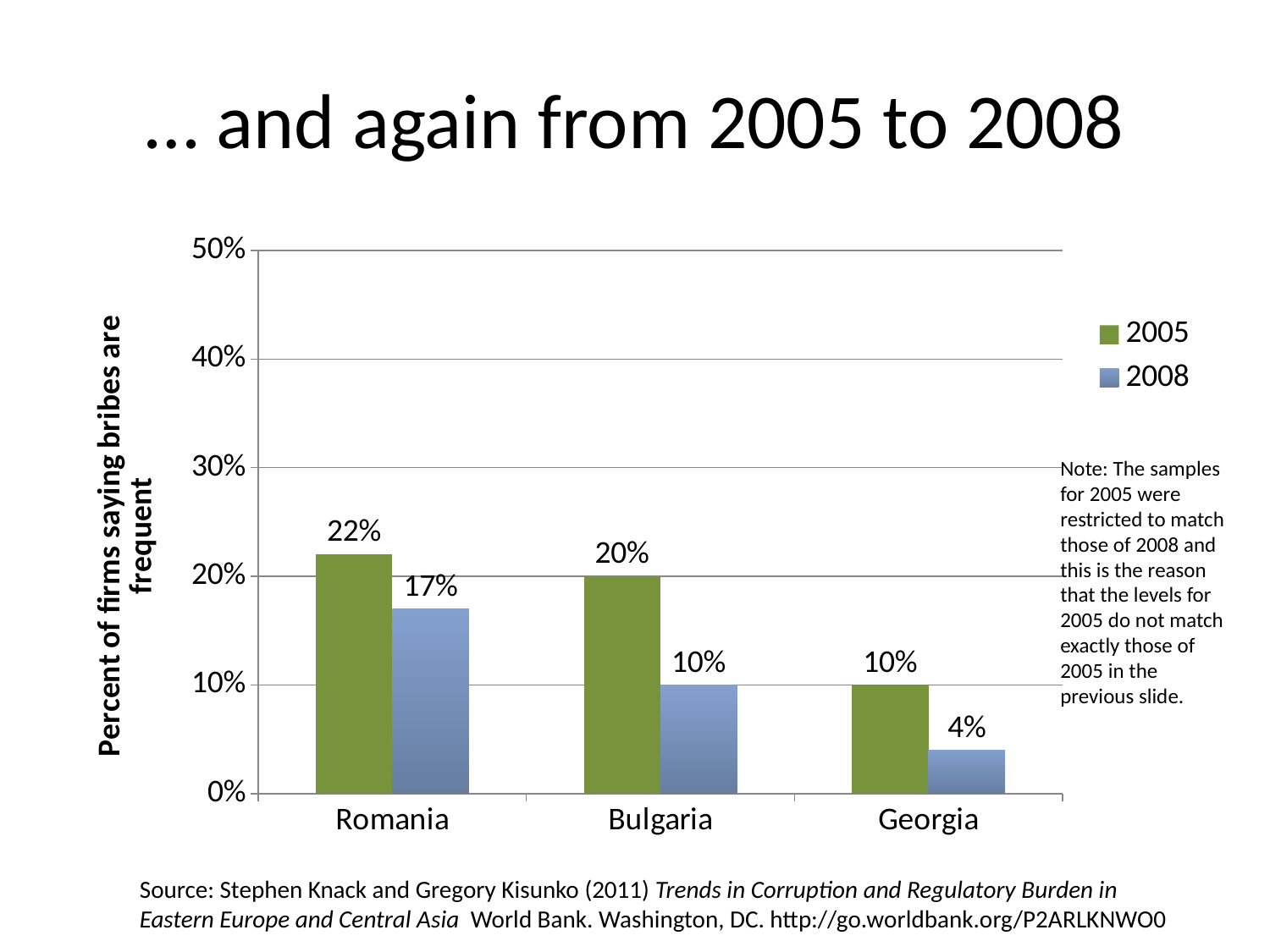
What is the label of the vertical axis? Percent of firms saying bribes are frequent Which is larger: the 2008 value for Romania or the 2005 value for Georgia? 2008 value for Romania What is the difference between the 2005 and 2008 values for Romania? 5% What is the 2008 value for Georgia? 4% Which country has the lowest 2008 value? Georgia How many countries are shown on the x axis? 3 What is the 2008 value for Bulgaria? 10% What percent of firms in Romania said bribes are frequent in 2005? 22% How many series does the legend list? 2 What kind of chart is shown on the slide? Bar chart What is the difference between the 2005 and 2008 values for Bulgaria? 10% Which country has the highest 2005 value? Romania